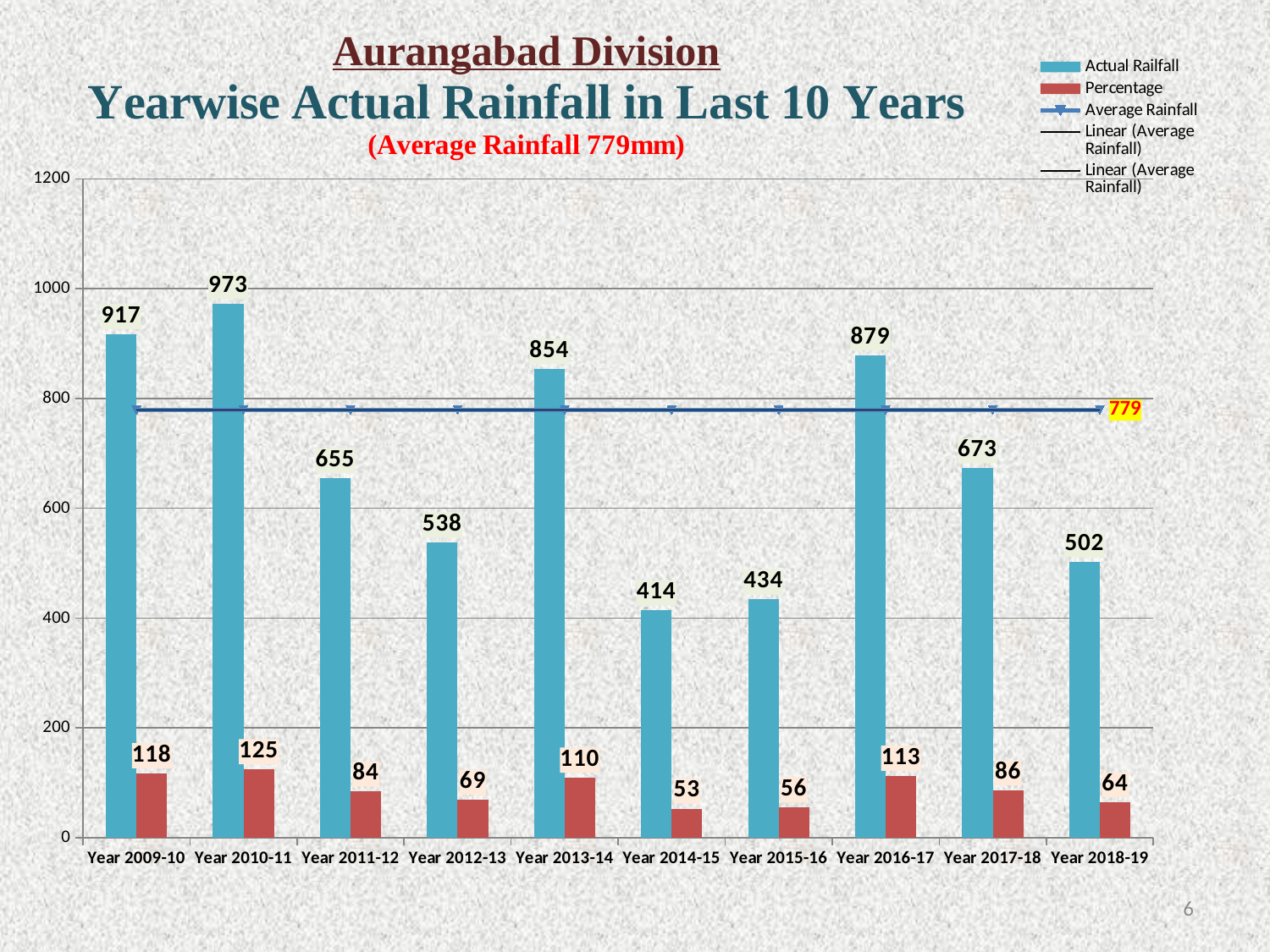
Which is larger, the Actual Rainfall for Year 2013-14 or for Year 2016-17? Year 2016-17 Is the Actual Rainfall for Year 2012-13 greater or less than 600? less What is the Percentage value for Year 2016-17? 113 Which year has the lowest Actual Rainfall? Year 2014-15 What is the Actual Rainfall value for Year 2010-11? 973 How many entries does the legend list? 5 What kind of chart is shown on the slide? combination bar and line chart Which year has the highest Actual Rainfall? Year 2010-11 What is the Percentage value for Year 2014-15? 53 What is the difference between the Actual Rainfall for Year 2009-10 and Year 2018-19? 415 What value is labelled on the Average Rainfall line? 779 How many years are shown on the x axis? 10